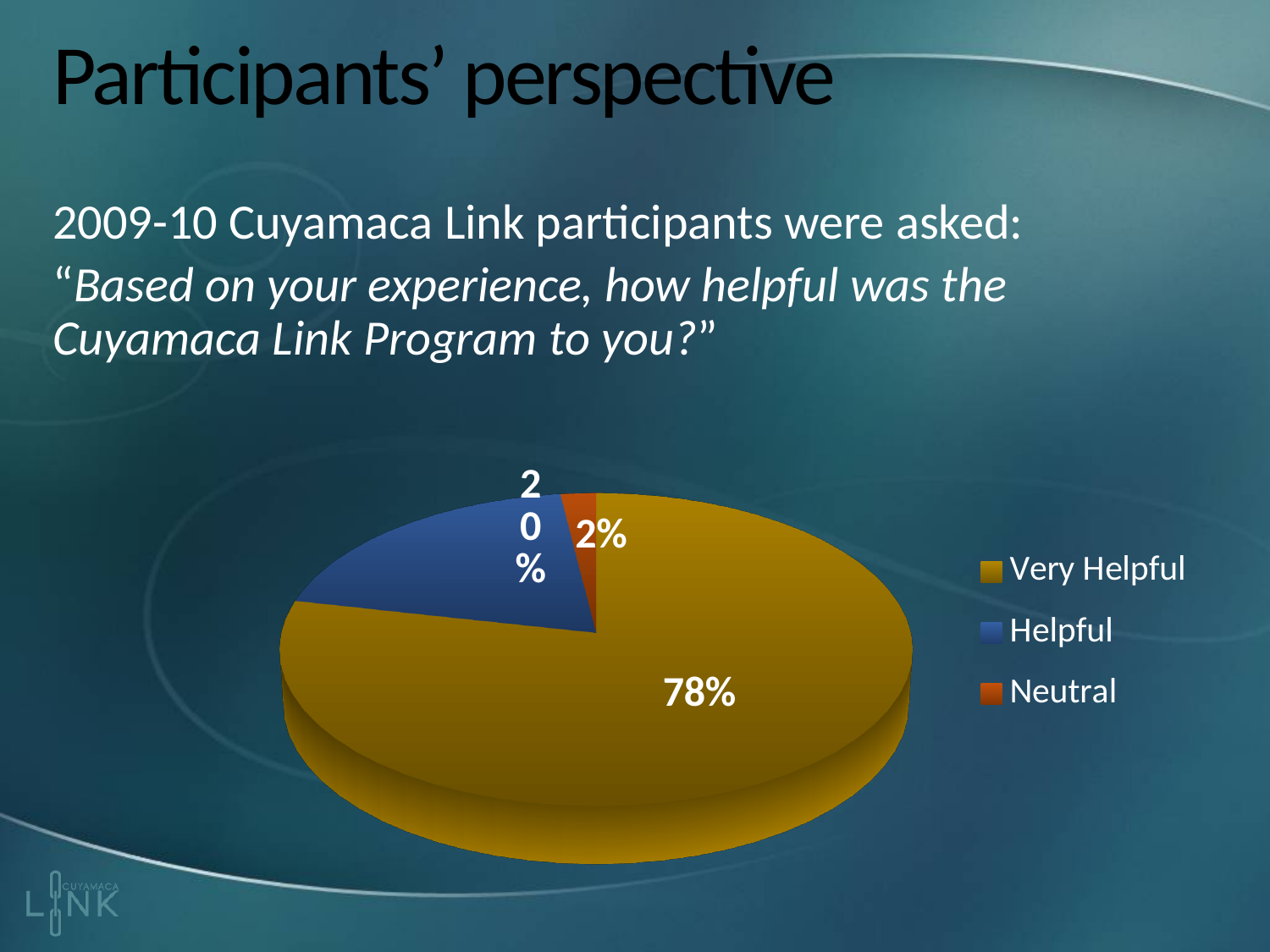
What percentage of participants rated the Cuyamaca Link Program as Very Helpful? 78% What kind of chart is shown on the slide? pie chart What is the difference in percentage points between the Very Helpful and Helpful slices? 58 What colour is the Very Helpful slice? gold What percentage of participants gave a Neutral rating? 2% Which response category has the smallest share of the pie? Neutral Which is larger, the Helpful slice or the Neutral slice? Helpful What percentage of participants rated the program as Helpful? 20% Which response category has the largest share of the pie? Very Helpful How many categories does the legend list? 3 How many slices does the pie chart have? 3 What colour is the Helpful slice? blue